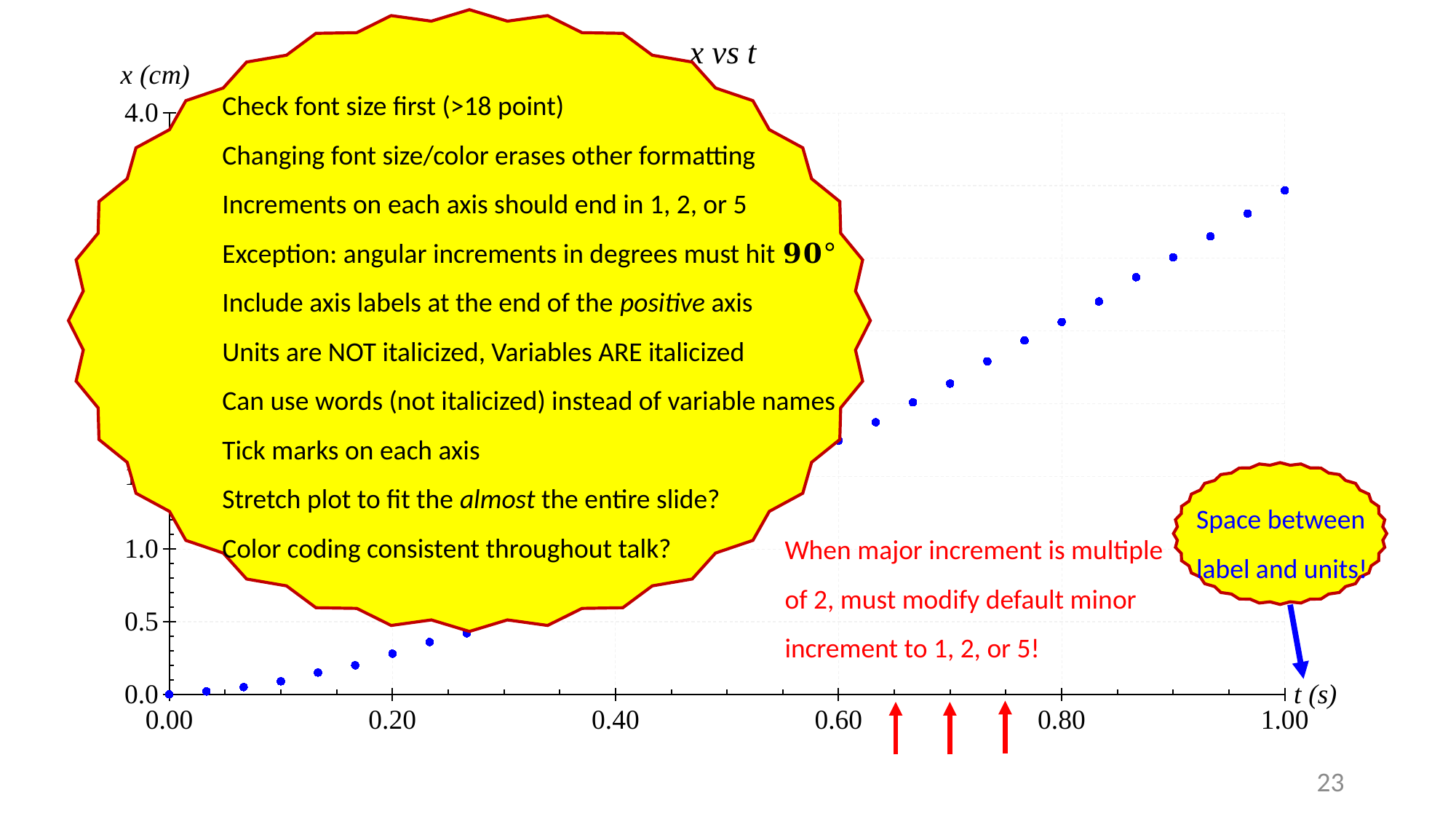
Which is larger, the plotted x value at t = 0.20 or at t = 0.80? t = 0.80 What kind of chart is shown on the slide? scatter chart Is the plotted x value at t = 0.20 greater or less than 0.5? less Do the plotted values rise or fall as t increases along the x axis? rise Is the plotted x value at t = 1.00 greater or less than 1.0? greater At which value of t is the plotted x value lowest? 0.00 What is the plotted x value at t = 0.00? 0.0 Is the plotted x value at t = 0.80 greater or less than 1.0? greater At which value of t is the plotted x value highest? 1.00 What is the title of the chart? x vs t Which is larger, the plotted x value at t = 0.60 or at t = 1.00? t = 1.00 What is the label on the vertical axis of the chart? x (cm)